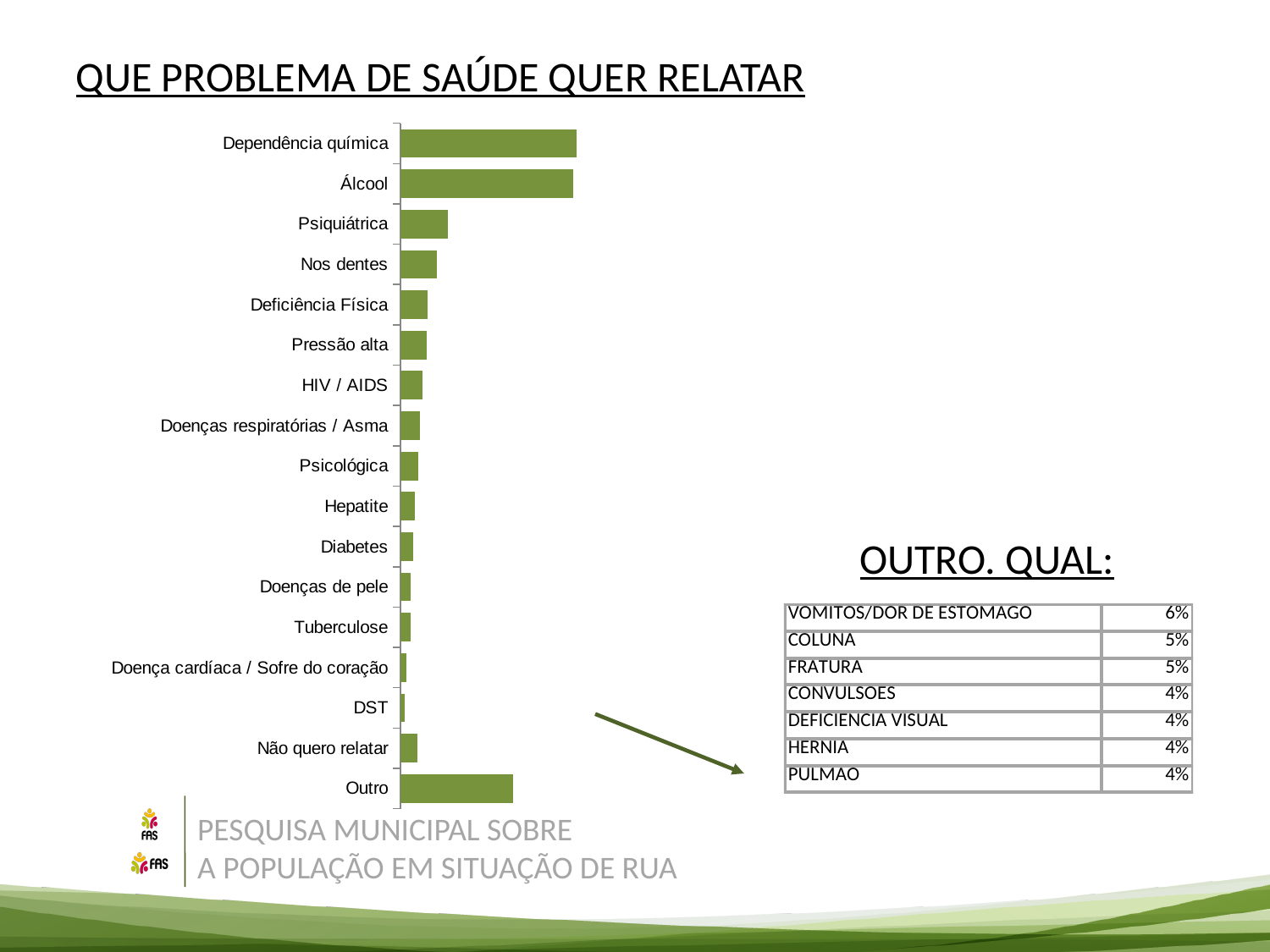
Which bar is longer, HIV / AIDS or Doenças de pele? HIV / AIDS What kind of chart is shown on the slide? bar chart Which bar is longer, Álcool or Psiquiátrica? Álcool Are the bars in the chart horizontal or vertical? horizontal Which bar is longer, Outro or Psiquiátrica? Outro Which category has the shortest bar in the chart? DST Which category is listed at the top of the chart? Dependência química What is the title of the chart on the slide? QUE PROBLEMA DE SAÚDE QUER RELATAR How many categories (bars) does the chart show? 17